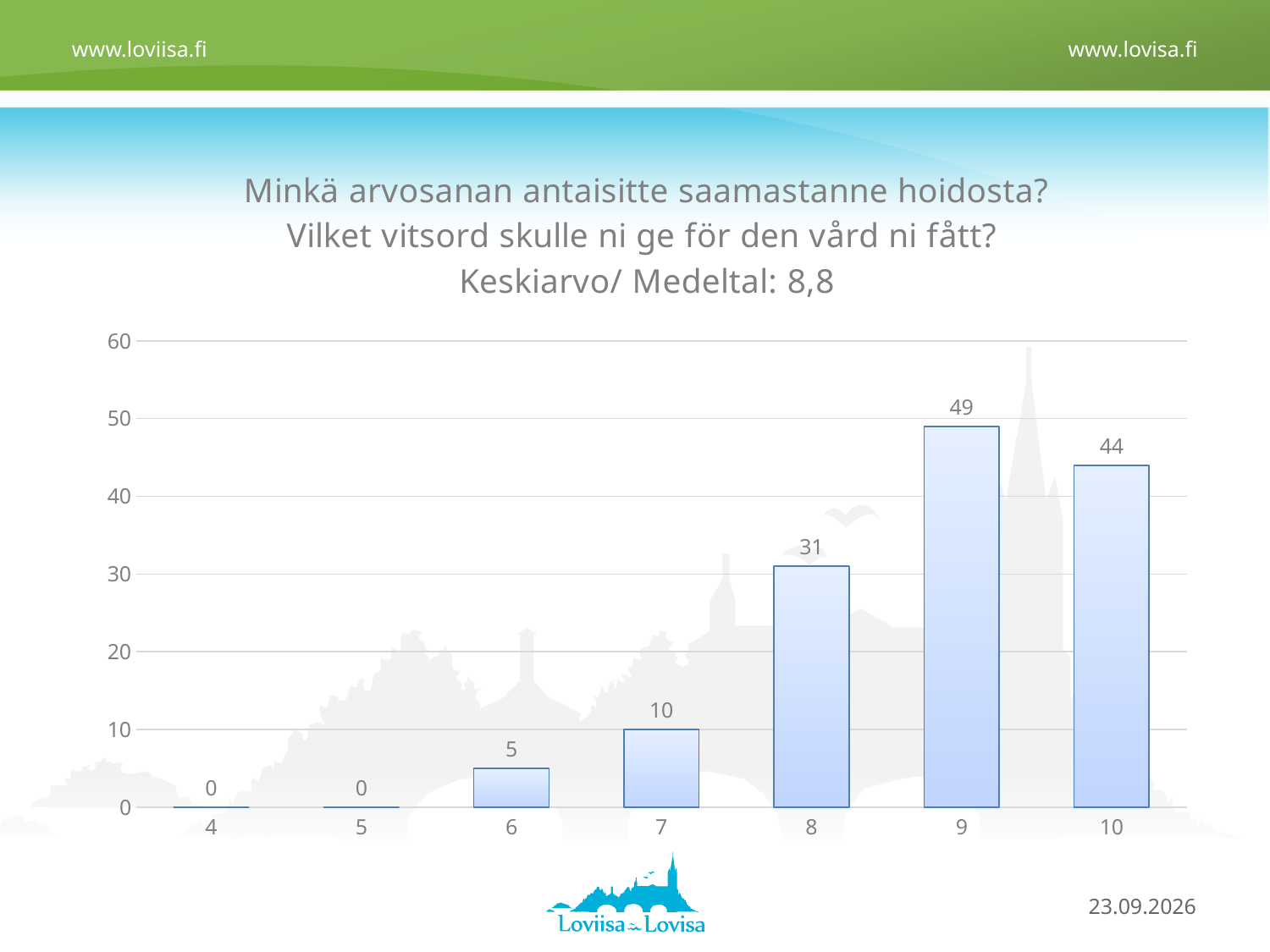
What kind of chart is shown on the slide? bar chart Is the value for grade 8 greater or less than 30? greater What is the value for grade 10? 44 Which is larger, the value for grade 8 or the value for grade 10? 10 What is the difference between the values for grade 9 and grade 10? 5 What is the value for grade 9? 49 How many grade categories are shown on the x axis? 7 What is the value for grade 7? 10 What is the difference between the values for grade 8 and grade 7? 21 What average (Keskiarvo/Medeltal) is stated in the chart title? 8,8 How many grades have a value of 0? 2 Which grade has the highest value? 9